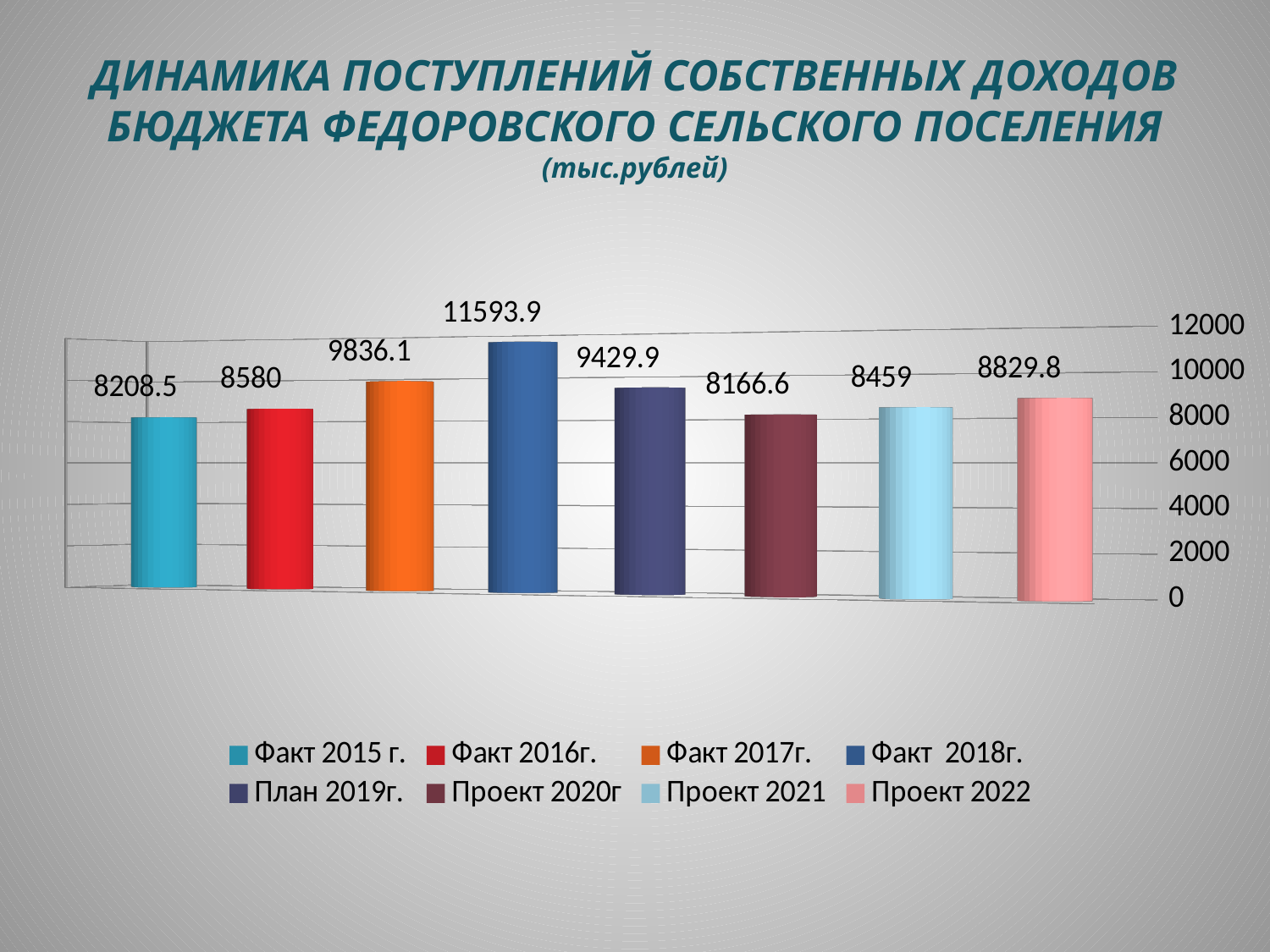
What is the difference between the values for Факт 2018г. and Факт 2017г.? 1757.8 Which series has the highest value? Факт 2018г. What is the value for Проект 2020г? 8166.6 How many series does the legend list? 8 Is the value for Факт 2015 г. greater or less than 10000? less What is the value for Проект 2022? 8829.8 What is the value for Факт 2016г.? 8580 How many bars are plotted on the chart? 8 Which series has the lowest value? Проект 2020г Which is larger, the value for План 2019г. or the value for Проект 2021? План 2019г. What kind of chart is shown on the slide? bar chart What is the value for Факт 2018г.? 11593.9